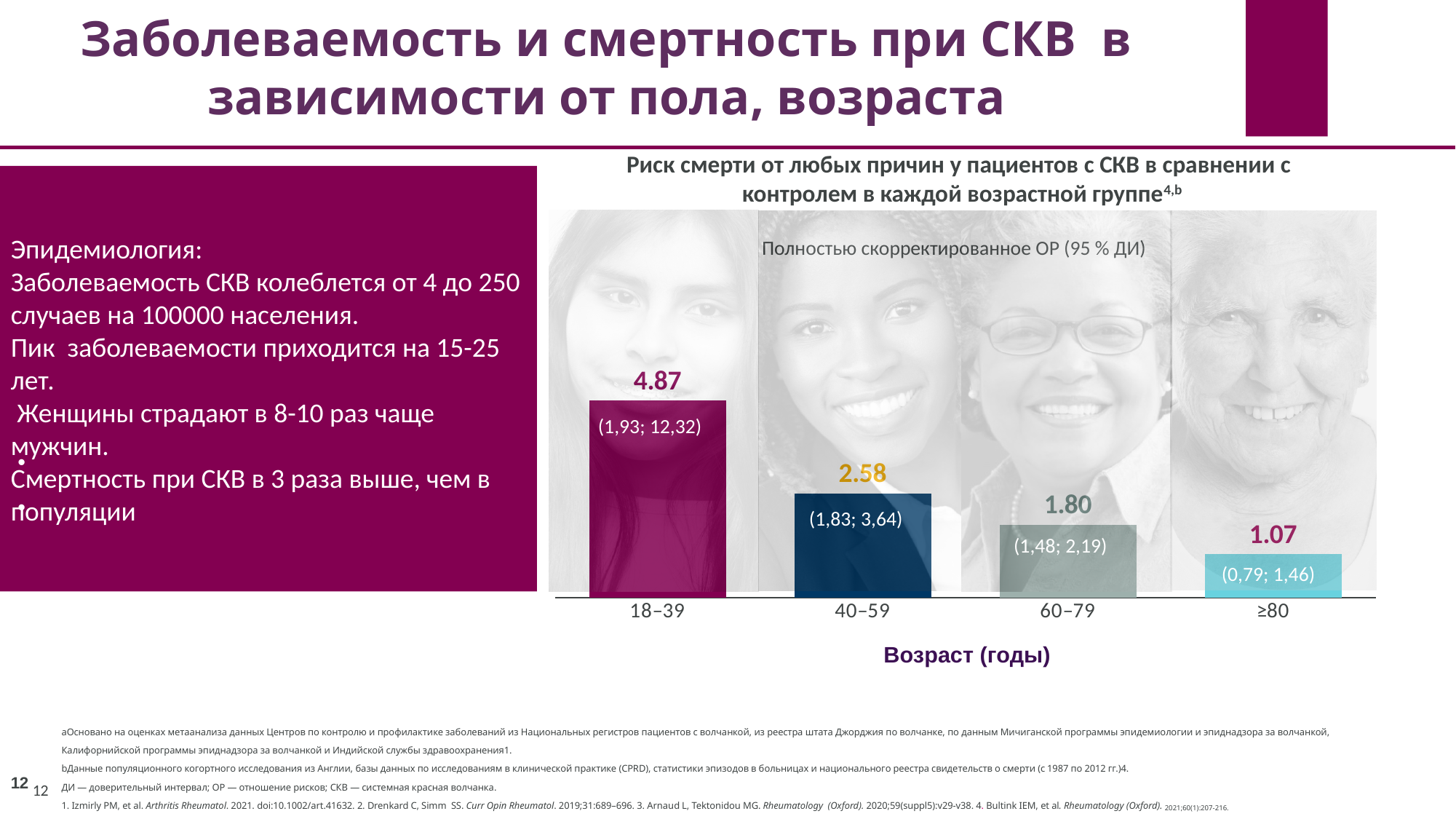
What is the 95% confidence interval shown for the ≥80 age group? (0,79; 1,46) What is the fully adjusted hazard ratio (ОР) for the ≥80 age group? 1.07 Do the hazard ratios rise or fall as age increases along the x axis? fall What is the difference between the hazard ratios for the 18–39 and 40–59 age groups? 2.29 Which age group has a larger hazard ratio, 60–79 or ≥80? 60–79 What is the fully adjusted hazard ratio (ОР) for the 18–39 age group? 4.87 What is the fully adjusted hazard ratio (ОР) for the 40–59 age group? 2.58 What is the fully adjusted hazard ratio (ОР) for the 60–79 age group? 1.80 What is the 95% confidence interval shown for the 18–39 age group? (1,93; 12,32) Which age group has the lowest hazard ratio? ≥80 Which age group has the highest hazard ratio? 18–39 How many age groups are shown on the chart? 4